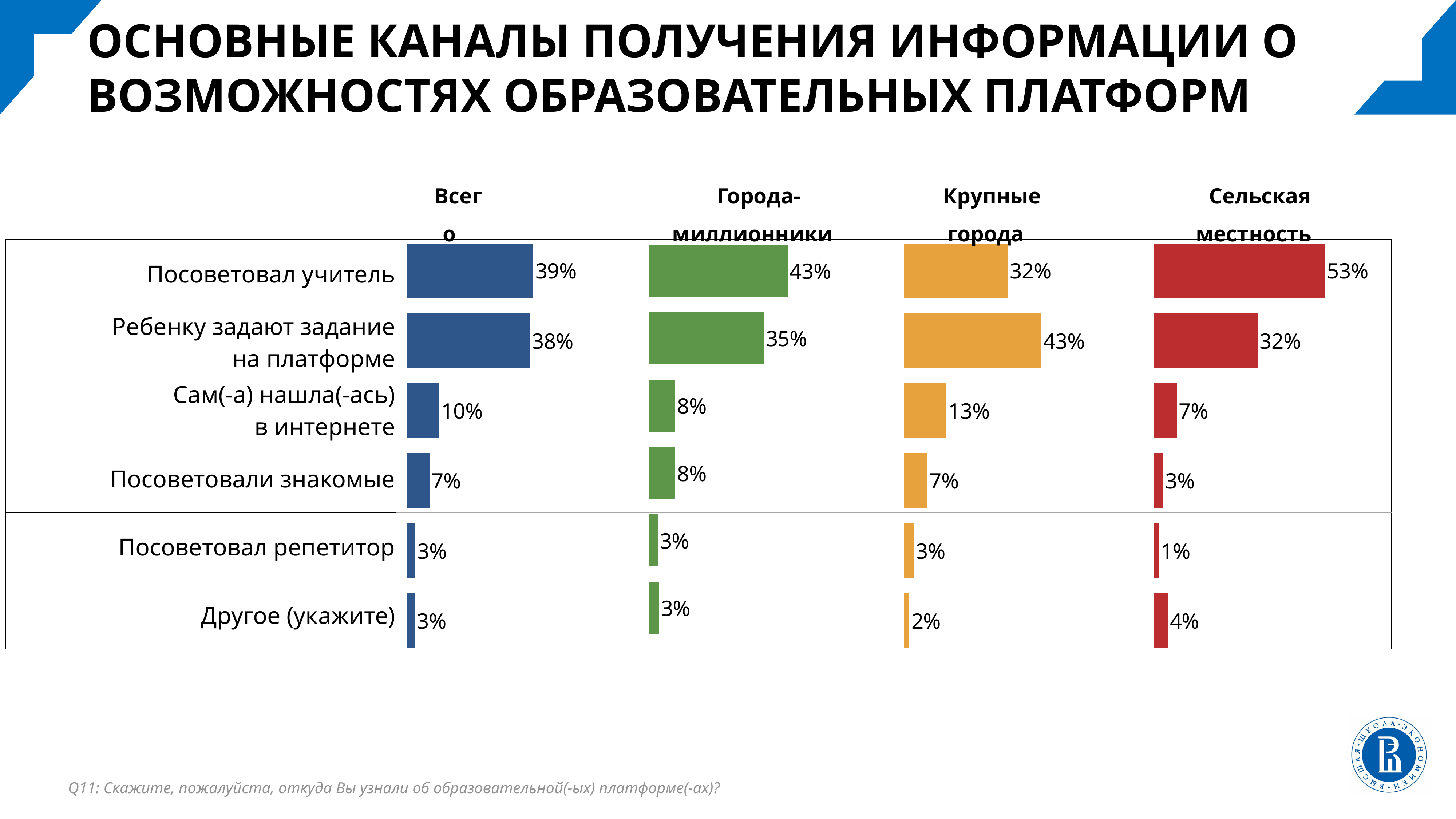
In the "Города-миллионники" chart, which category has the highest value? Посоветовал учитель In the "Сельская местность" chart, what is the difference between "Посоветовал учитель" and "Ребенку задают задание на платформе"? 21% In the "Всего" chart, what is the value for "Посоветовал учитель"? 39% In the "Города-миллионники" chart, what is the difference between "Посоветовал учитель" and "Ребенку задают задание на платформе"? 8% How many categories are shown in the "Всего" chart? 6 What colour are the bars in the "Крупные города" chart? Orange In the "Крупные города" chart, which category has the highest value? Ребенку задают задание на платформе In the "Сельская местность" chart, which category has the lowest value? Посоветовал репетитор In the "Всего" chart, which is larger: "Сам(-а) нашла(-ась) в интернете" or "Посоветовали знакомые"? Сам(-а) нашла(-ась) в интернете In the "Крупные города" chart, what is the value for "Сам(-а) нашла(-ась) в интернете"? 13% What kind of chart is used for the "Города-миллионники" data? Bar chart In the "Сельская местность" chart, what is the value for "Ребенку задают задание на платформе"? 32%